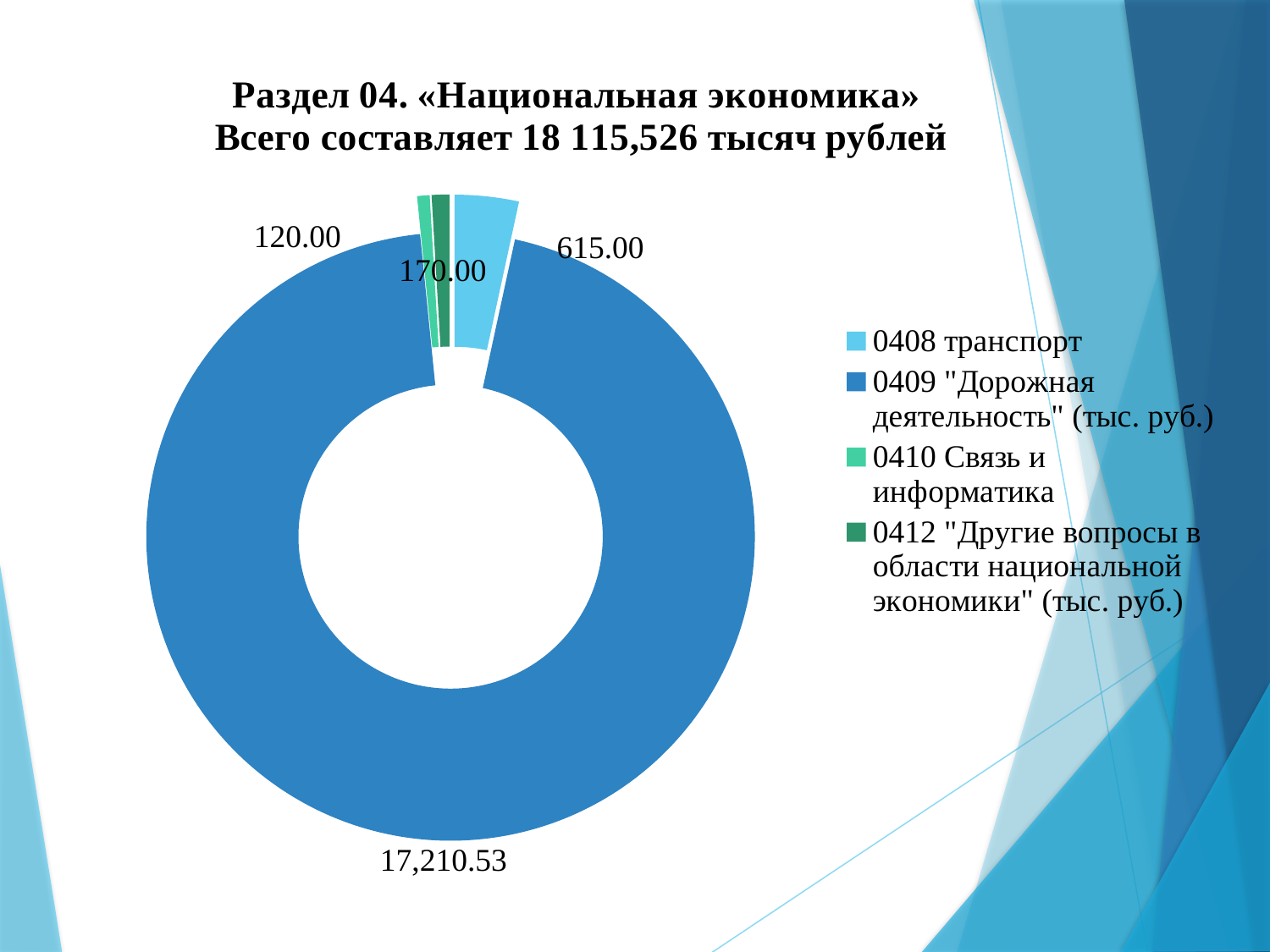
What is the smallest value labelled on the chart? 120.00 How many categories does the chart show? 4 How many entries does the legend list? 4 Which is larger, the value for 0408 транспорт or the value for 0409 "Дорожная деятельность"? 0409 "Дорожная деятельность" Which category has the largest share of the chart? 0409 "Дорожная деятельность" (тыс. руб.) What is the value for 0408 транспорт? 615.00 What is the difference between the values for 0409 "Дорожная деятельность" and 0408 транспорт? 16,595.53 According to the slide title, what is the total for Раздел 04? 18 115,526 тысяч рублей What type of chart is shown on the slide? Doughnut (pie) chart What is the value for 0409 "Дорожная деятельность" (тыс. руб.)? 17,210.53 What is the title of the slide above the chart? Раздел 04. «Национальная экономика» Всего составляет 18 115,526 тысяч рублей